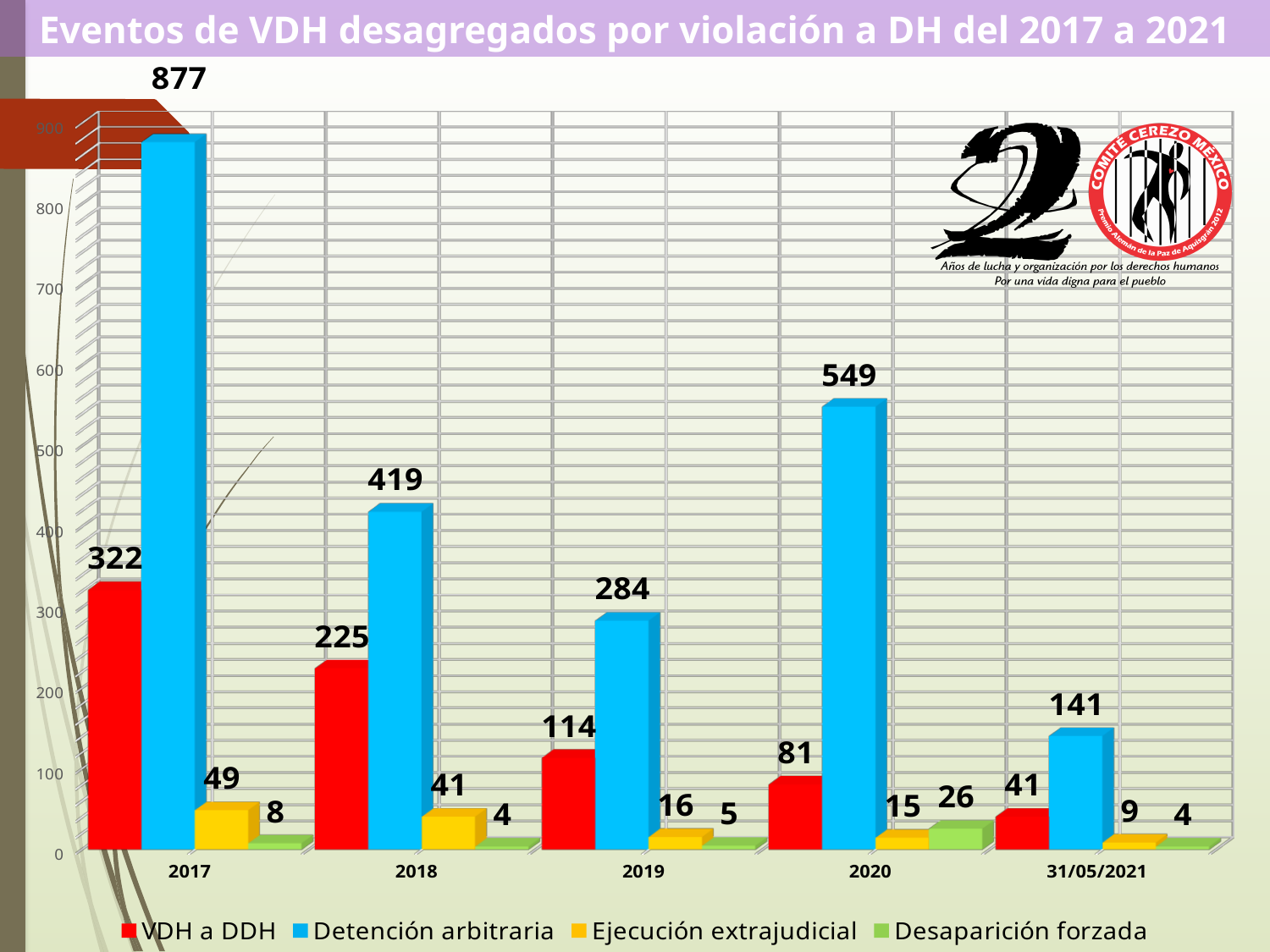
What is the difference between Detención arbitraria in 2020 and in 2019? 265 In which year is Detención arbitraria lowest? 31/05/2021 What is the value for Desaparición forzada in 2020? 26 In which year is VDH a DDH highest? 2017 Which is larger: VDH a DDH in 2019 or VDH a DDH in 2020? VDH a DDH in 2019 How many categories are shown on the x axis? 5 What is the value for Ejecución extrajudicial in 2019? 16 What is the value for VDH a DDH in 2018? 225 What is the value for Detención arbitraria in 2017? 877 What kind of chart is shown? bar chart How many series does the legend list? 4 Does the value for VDH a DDH rise or fall from 2017 to 31/05/2021? fall